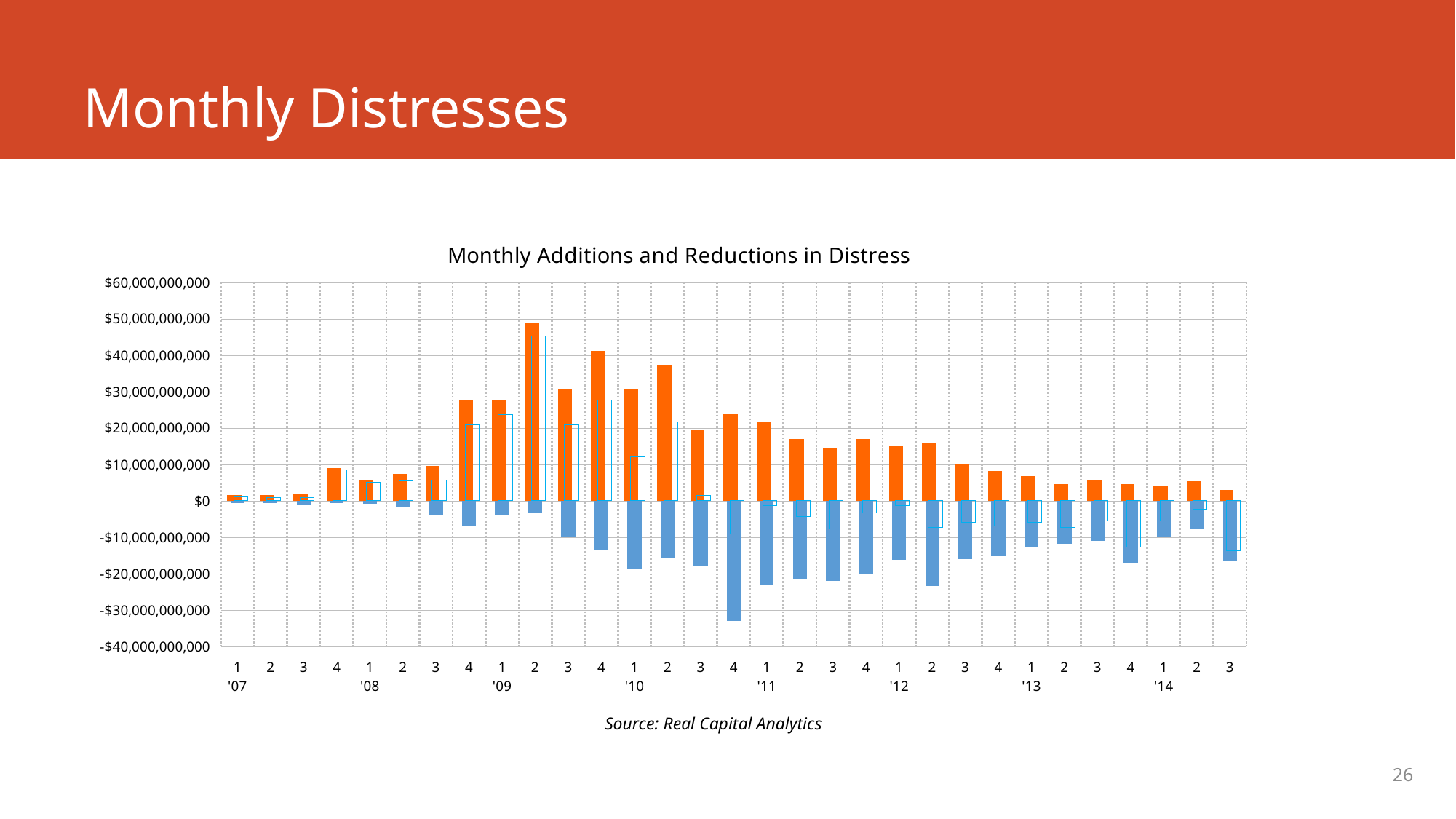
Is the blue bar for Q4 '10 greater or less than -$30,000,000,000? less In which quarter does the blue (reductions) bar reach its lowest (most negative) value? Q4 '10 In which quarter does the orange (additions) bar reach its highest value? Q2 '09 Do the orange bars generally rise or fall from Q2 '09 to Q3 '14? Fall What is the title of the chart? Monthly Additions and Reductions in Distress Is the orange bar for Q2 '10 greater or less than $40,000,000,000? less What kind of chart is shown on the slide? Bar chart Is the orange bar for Q3 '14 greater or less than $10,000,000,000? less Which quarter has the more negative blue bar, Q4 '10 or Q1 '11? Q4 '10 Which has the taller orange bar, Q2 '09 or Q4 '09? Q2 '09 How many quarterly categories are plotted along the x axis? 31